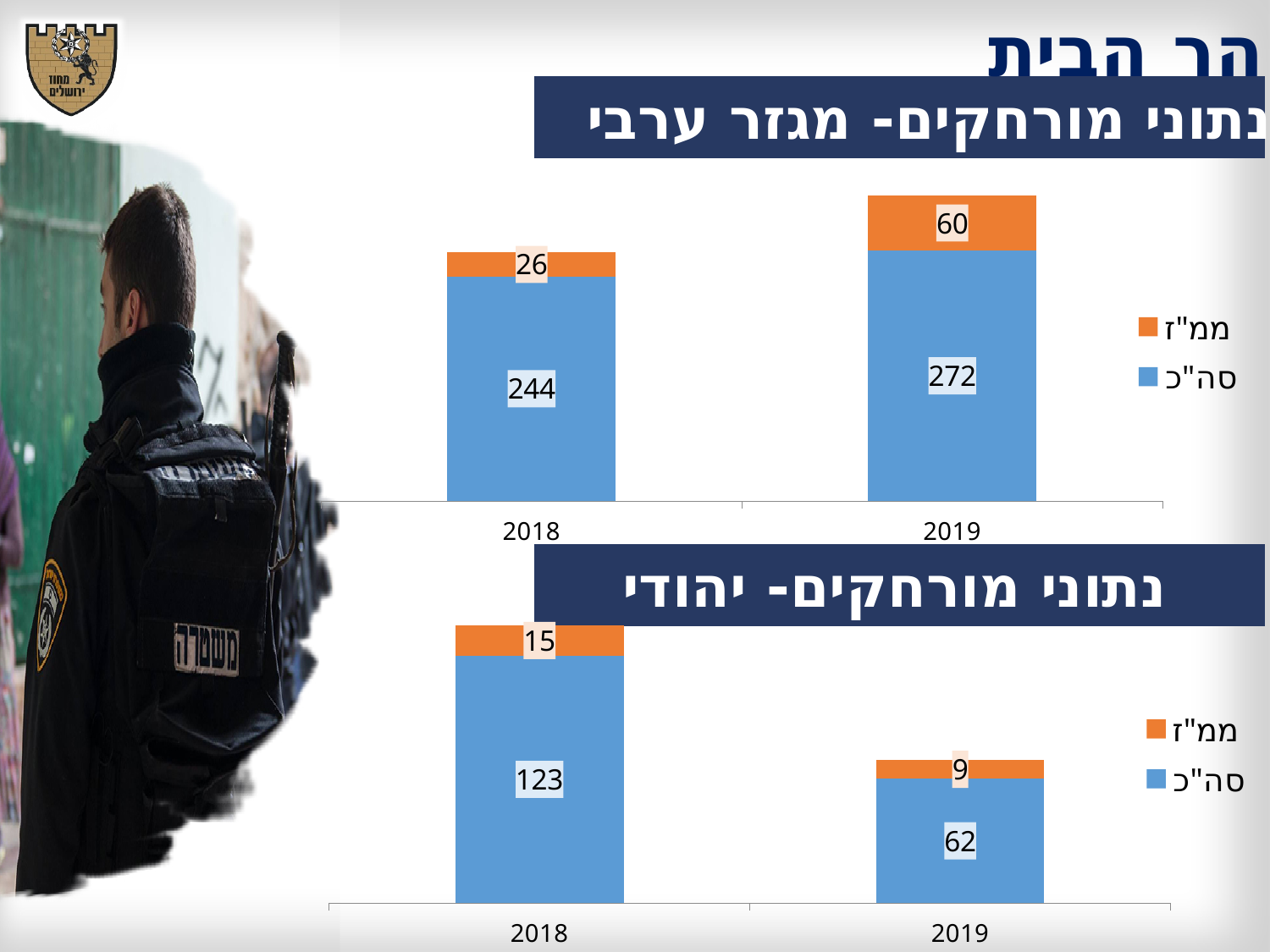
How many series does the legend of the top chart (נתוני מורחקים- מגזר ערבי) list? 2 In the top chart (נתוני מורחקים- מגזר ערבי), what is the value of the סה"כ series for 2019? 272 In the top chart (נתוני מורחקים- מגזר ערבי), what is the difference between the ממ"ז values for 2019 and 2018? 34 In the top chart (נתוני מורחקים- מגזר ערבי), what is the total of the stacked bar for 2019? 332 In the bottom chart (נתוני מורחקים- יהודי), what is the value of the סה"כ series for 2018? 123 In the bottom chart (נתוני מורחקים- יהודי), do the סה"כ values rise or fall from 2018 to 2019? fall In the bottom chart (נתוני מורחקים- יהודי), what is the total of the stacked bar for 2018? 138 In the top chart (נתוני מורחקים- מגזר ערבי), what is the value of the ממ"ז series for 2018? 26 In the bottom chart (נתוני מורחקים- יהודי), which year has the larger סה"כ value, 2018 or 2019? 2018 In the bottom chart (נתוני מורחקים- יהודי), what is the value of the ממ"ז series for 2019? 9 In the bottom chart (נתוני מורחקים- יהודי), what is the difference between the סה"כ values for 2018 and 2019? 61 What kind of chart is the bottom chart (נתוני מורחקים- יהודי)? stacked bar chart